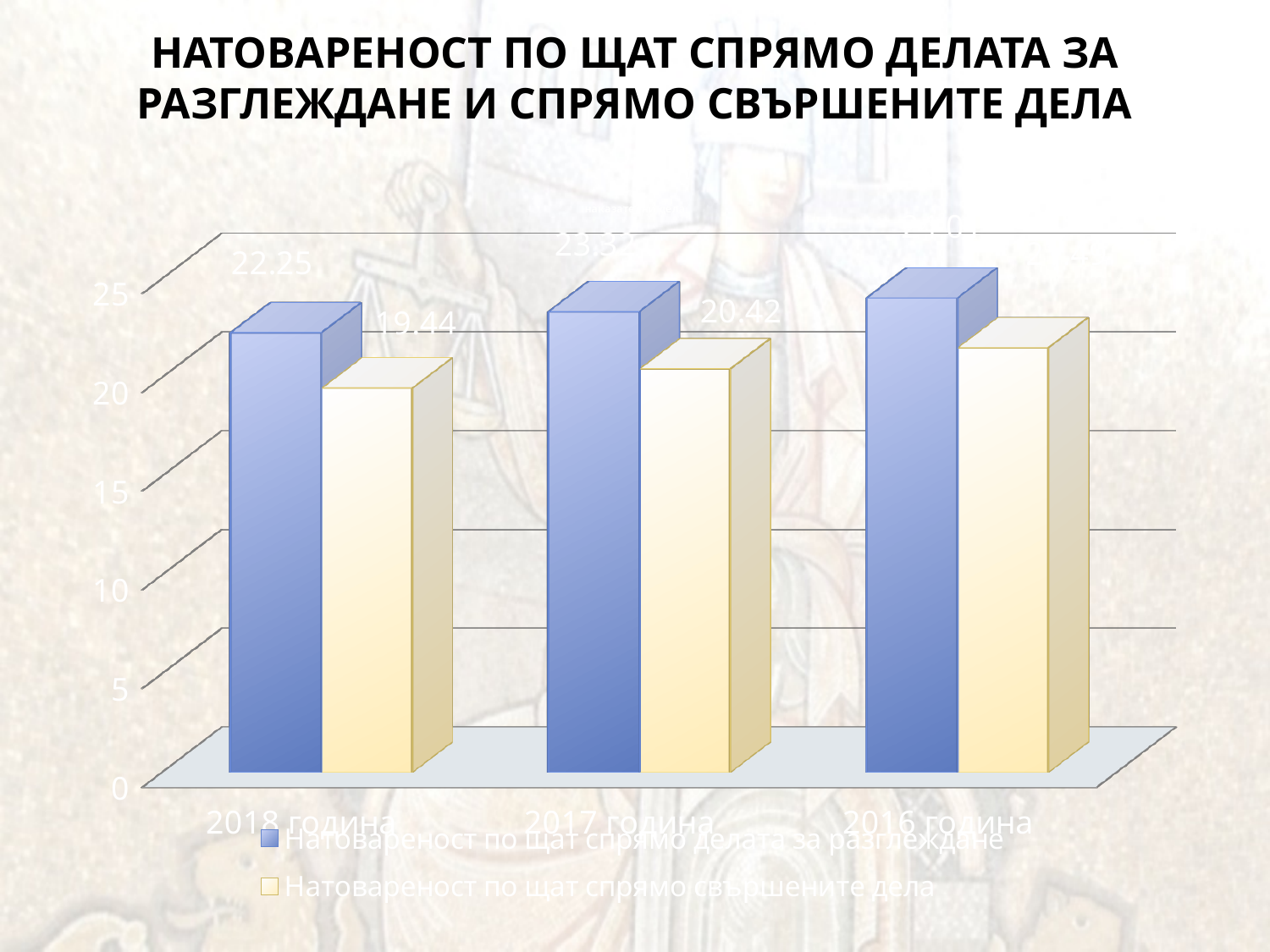
Do the values for Натовареност по щат спрямо делата за разглеждане rise or fall from left to right along the x axis? rise How many year categories are shown on the x axis? 3 For 2018 година, what is the difference between Натовареност по щат спрямо делата за разглеждане and Натовареност по щат спрямо свършените дела? 2.81 Is the value of Натовареност по щат спрямо свършените дела for 2016 година greater or less than 20? greater Which is larger for 2018 година: Натовареност по щат спрямо делата за разглеждане or Натовареност по щат спрямо свършените дела? Натовареност по щат спрямо делата за разглеждане What kind of chart is shown on the slide? bar chart Which year has the lowest value for Натовареност по щат спрямо свършените дела? 2018 година What is the value of Натовареност по щат спрямо свършените дела for 2018 година? 19.44 Which year has the highest value for Натовареност по щат спрямо делата за разглеждане? 2016 година What is the value of Натовареност по щат спрямо делата за разглеждане for 2018 година? 22.25 What is the value of Натовареност по щат спрямо свършените дела for 2017 година? 20.42 How many series does the legend list? 2